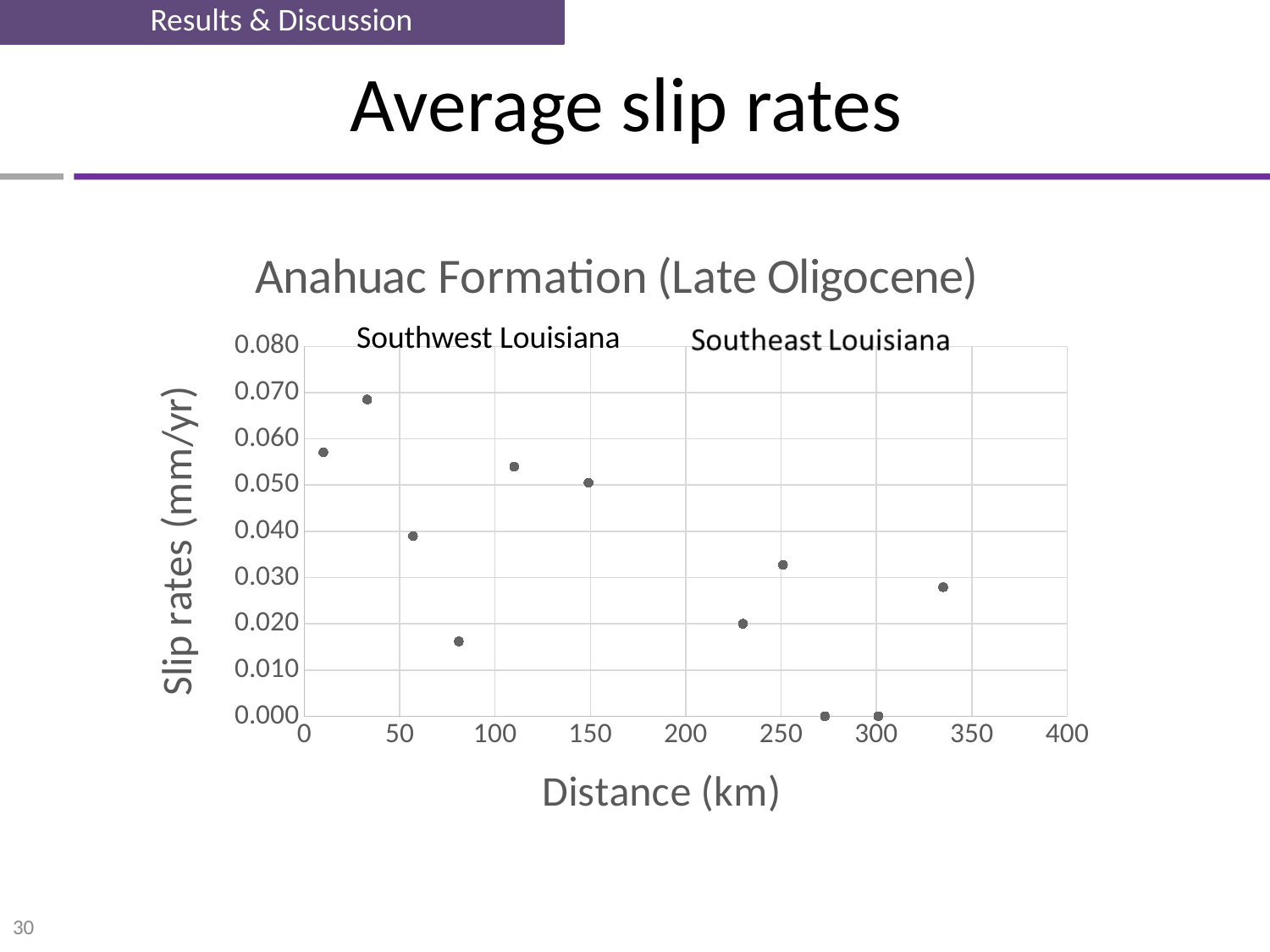
What is the label of the y axis of the chart? Slip rates (mm/yr) Is the slip rate of the point at roughly 80 km greater or less than 0.020 mm/yr? less How many points on the chart lie on the 0.000 mm/yr line? 2 Is the slip rate of the point at roughly 335 km greater or less than 0.040 mm/yr? less Is the slip rate of the point at roughly 250 km greater or less than 0.020 mm/yr? greater What is the title of the chart? Anahuac Formation (Late Oligocene) What kind of chart is shown on the slide? Scatter chart Which has the higher slip rate: the point at roughly 150 km or the point at roughly 230 km? The point at roughly 150 km Under which region label, Southwest Louisiana or Southeast Louisiana, does the highest slip rate point appear? Southwest Louisiana How many data points are plotted on the chart? 11 Overall, do the slip rates tend to rise or fall as distance increases along the x axis? Fall